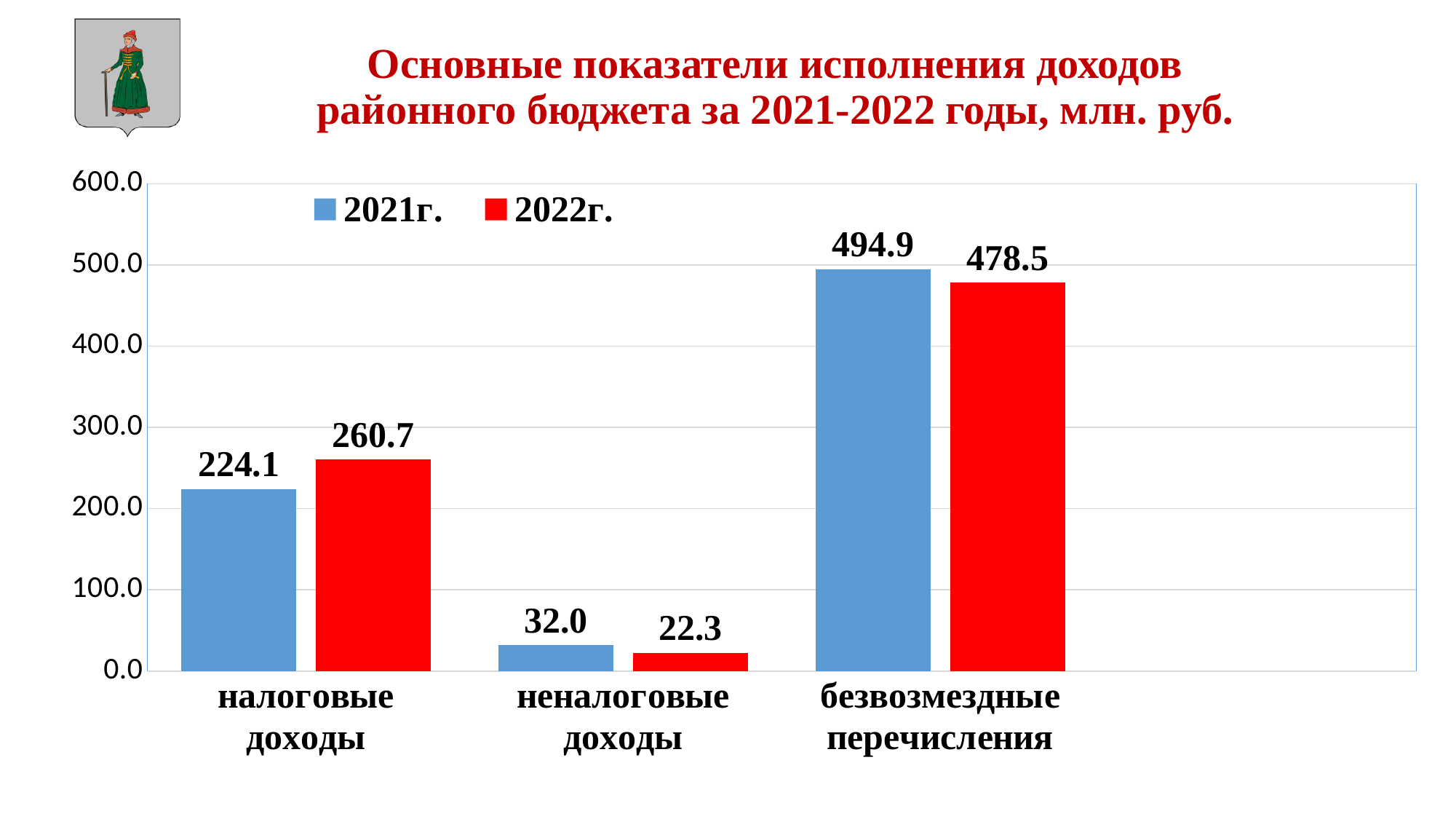
What is the difference between the 2022г. and 2021г. values for налоговые доходы? 36.6 Which is larger for неналоговые доходы: the 2021г. value or the 2022г. value? 2021г. Which category has the highest value in 2022г.? безвозмездные перечисления What is the value for налоговые доходы in 2021г.? 224.1 What kind of chart is shown on the slide? bar chart What is the value for неналоговые доходы in 2022г.? 22.3 What is the difference between the 2021г. and 2022г. values for безвозмездные перечисления? 16.4 Is the 2022г. value for налоговые доходы greater or less than 300.0? less How many categories are shown on the x axis? 3 How many series does the legend list? 2 What is the value for безвозмездные перечисления in 2021г.? 494.9 Which category has the lowest value in 2021г.? неналоговые доходы